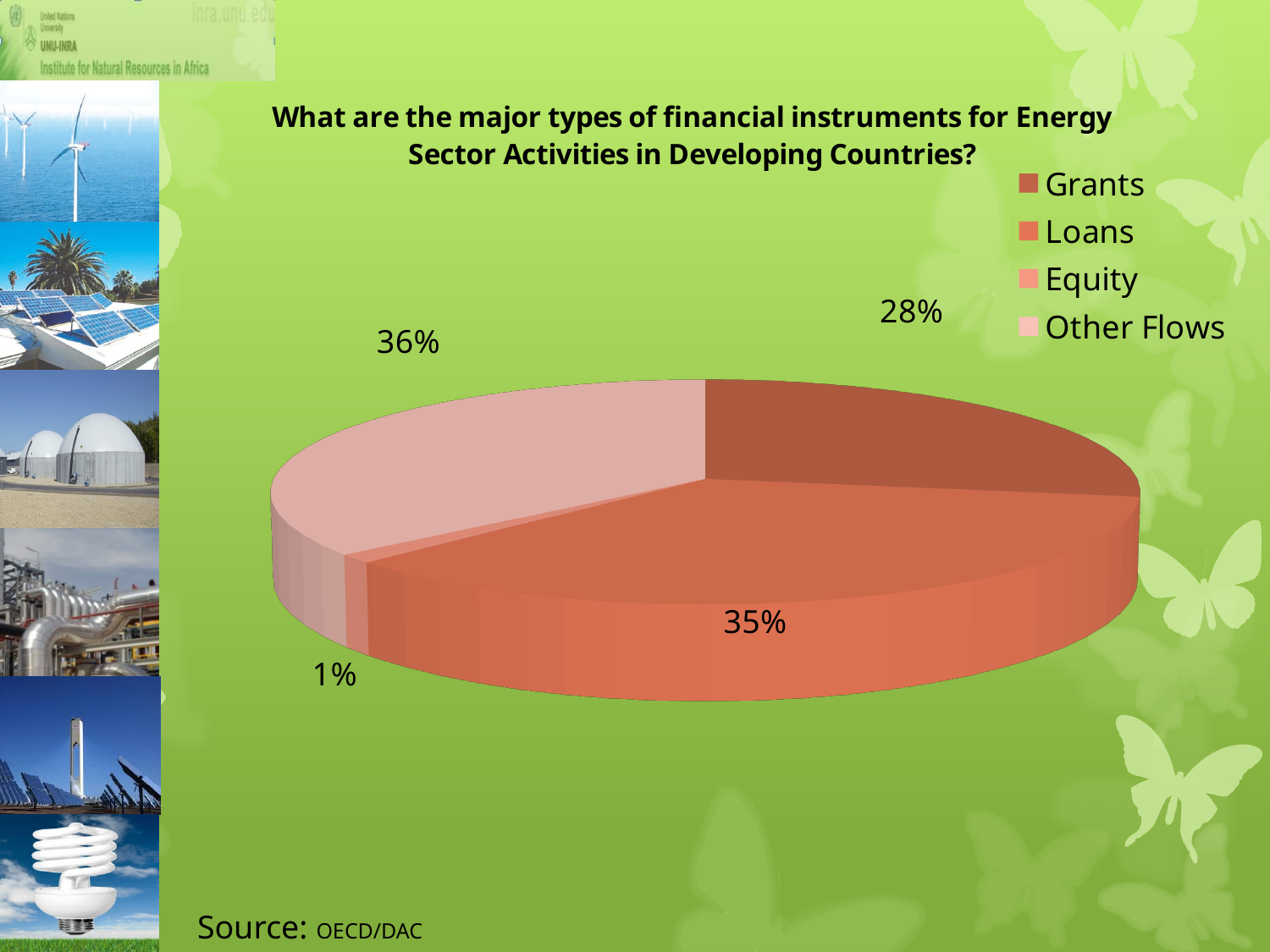
What type of chart is shown on the slide? Pie chart What percentage of the pie is Other Flows? 36% What is the difference in percentage points between Loans and Grants? 7 What is the source cited for the chart? OECD/DAC Which financial instrument has the smallest share of the pie? Equity Which financial instrument has the largest share of the pie? Other Flows What is the title of the chart? What are the major types of financial instruments for Energy Sector Activities in Developing Countries? What percentage of the pie is Loans? 35% How many categories does the pie chart show? 4 What percentage of the pie is Equity? 1% Which is larger, the share for Grants or the share for Loans? Loans What percentage of the pie is Grants? 28%